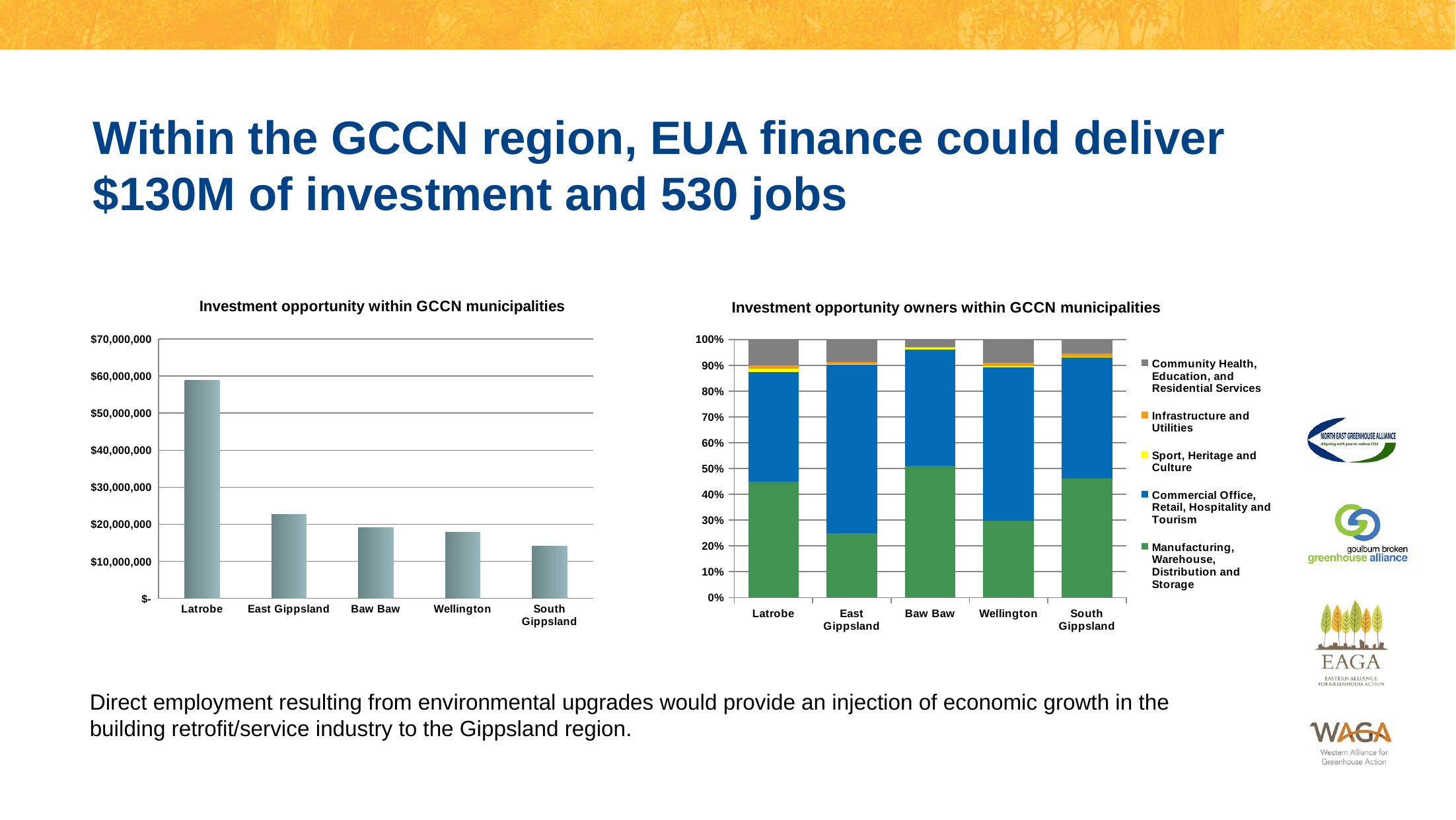
In the chart titled 'Investment opportunity within GCCN municipalities', what kind of chart is shown? bar chart In the chart titled 'Investment opportunity owners within GCCN municipalities', which series is shown in blue? Commercial Office, Retail, Hospitality and Tourism In the chart titled 'Investment opportunity within GCCN municipalities', how many municipalities are plotted? 5 In the chart titled 'Investment opportunity within GCCN municipalities', do the values rise or fall from left to right along the x axis? fall In the chart titled 'Investment opportunity within GCCN municipalities', is the value for Latrobe greater or less than $50,000,000? greater In the chart titled 'Investment opportunity owners within GCCN municipalities', is the Manufacturing, Warehouse, Distribution and Storage share for Wellington greater or less than 40%? less In the chart titled 'Investment opportunity owners within GCCN municipalities', how many series does the legend list? 5 In the chart titled 'Investment opportunity owners within GCCN municipalities', which municipality has the larger Manufacturing, Warehouse, Distribution and Storage share, Baw Baw or East Gippsland? Baw Baw In the chart titled 'Investment opportunity within GCCN municipalities', which municipality has the highest investment opportunity? Latrobe In the chart titled 'Investment opportunity within GCCN municipalities', which is larger, the value for Latrobe or the value for East Gippsland? Latrobe In the chart titled 'Investment opportunity within GCCN municipalities', is the value for East Gippsland greater or less than $30,000,000? less In the chart titled 'Investment opportunity within GCCN municipalities', which municipality has the lowest investment opportunity? South Gippsland